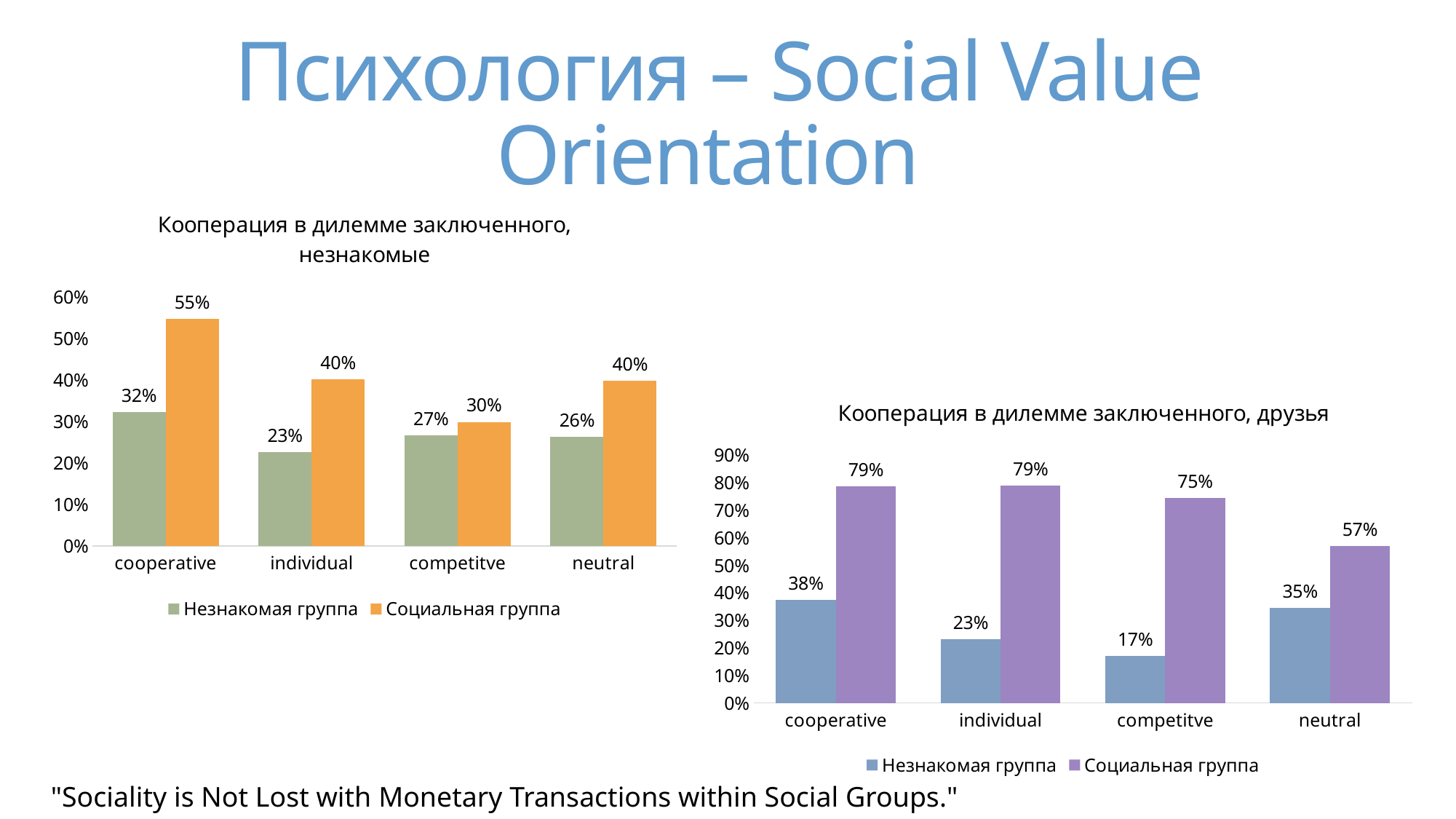
In the chart titled "Кооперация в дилемме заключенного, незнакомые", how many series does the legend list? 2 In the chart titled "Кооперация в дилемме заключенного, друзья", what is the value for Социальная группа in the neutral category? 57% In the chart titled "Кооперация в дилемме заключенного, незнакомые", what is the difference between Социальная группа and Незнакомая группа in the cooperative category? 23% In the chart titled "Кооперация в дилемме заключенного, друзья", which is larger in the neutral category: Незнакомая группа or Социальная группа? Социальная группа In the chart titled "Кооперация в дилемме заключенного, друзья", what is the difference between Социальная группа and Незнакомая группа in the competitve category? 58% What kind of chart is the chart titled "Кооперация в дилемме заключенного, незнакомые"? bar chart In the chart titled "Кооперация в дилемме заключенного, друзья", what is the value for Незнакомая группа in the competitve category? 17% In the chart titled "Кооперация в дилемме заключенного, незнакомые", what is the value for Социальная группа in the cooperative category? 55% In the chart titled "Кооперация в дилемме заключенного, незнакомые", what is the value for Незнакомая группа in the individual category? 23% How many categories are shown on the x axis of the chart titled "Кооперация в дилемме заключенного, друзья"? 4 In the chart titled "Кооперация в дилемме заключенного, незнакомые", which category has the lowest value for Незнакомая группа? individual In the chart titled "Кооперация в дилемме заключенного, друзья", which category has the highest value for Незнакомая группа? cooperative